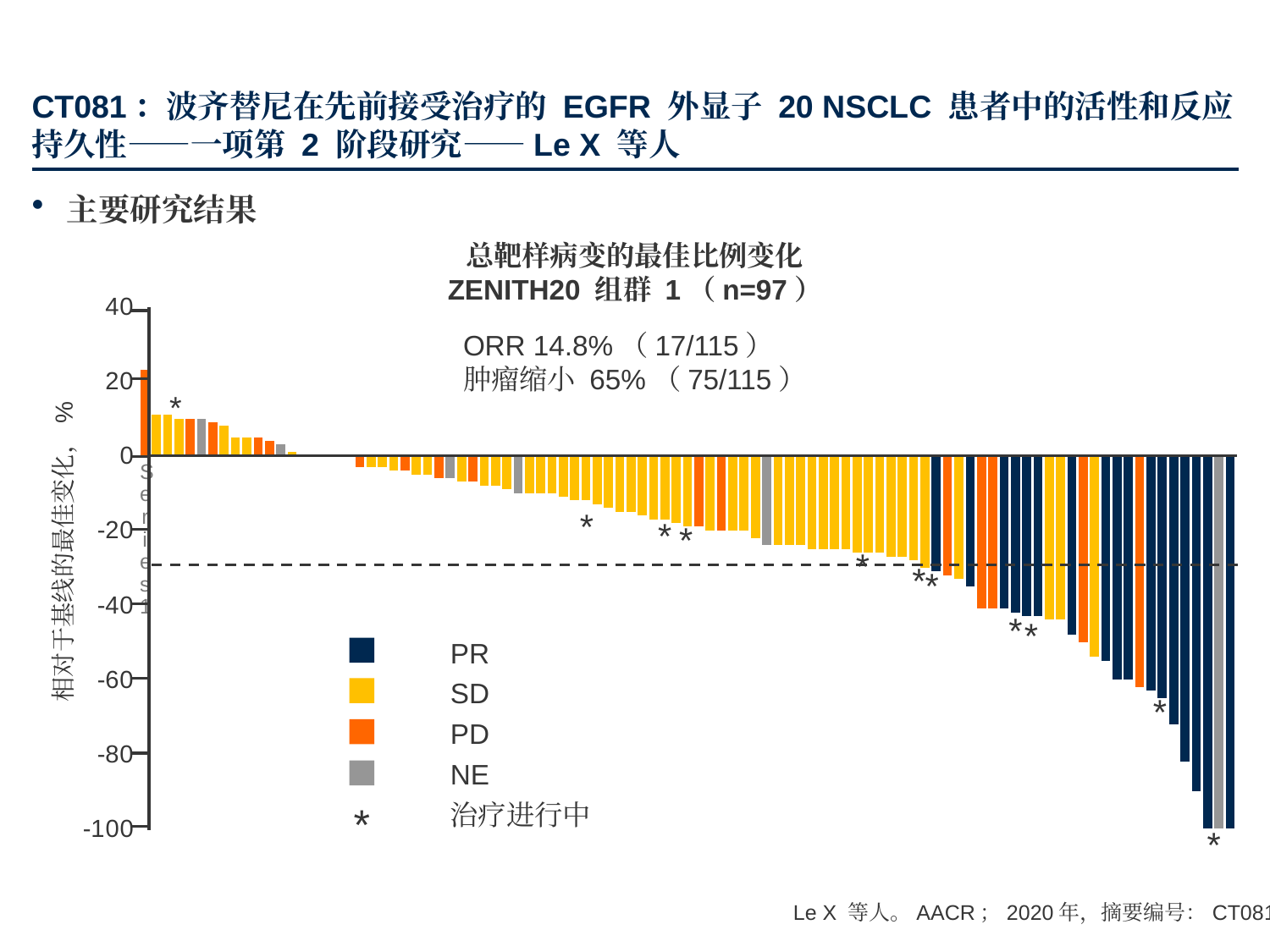
Is the value of the highest bar in the chart greater or less than 40? less Do the bar values rise or fall moving from left to right along the x axis? Fall Which colour represents PR in the chart legend? Dark blue According to the chart title, how many patients (n) are in ZENITH20 组群 1? 97 What does the asterisk (*) denote in the chart legend? 治疗进行中 What ORR is stated on the chart? 14.8% (17/115) What kind of chart is shown on the slide? Bar chart Is the value of the lowest bar in the chart greater or less than -80? less What tumour shrinkage rate (肿瘤缩小) is stated on the chart? 65% (75/115) How many response categories does the chart legend list (excluding the asterisk marker)? 4 Is the value of the leftmost bar greater or less than 0? greater